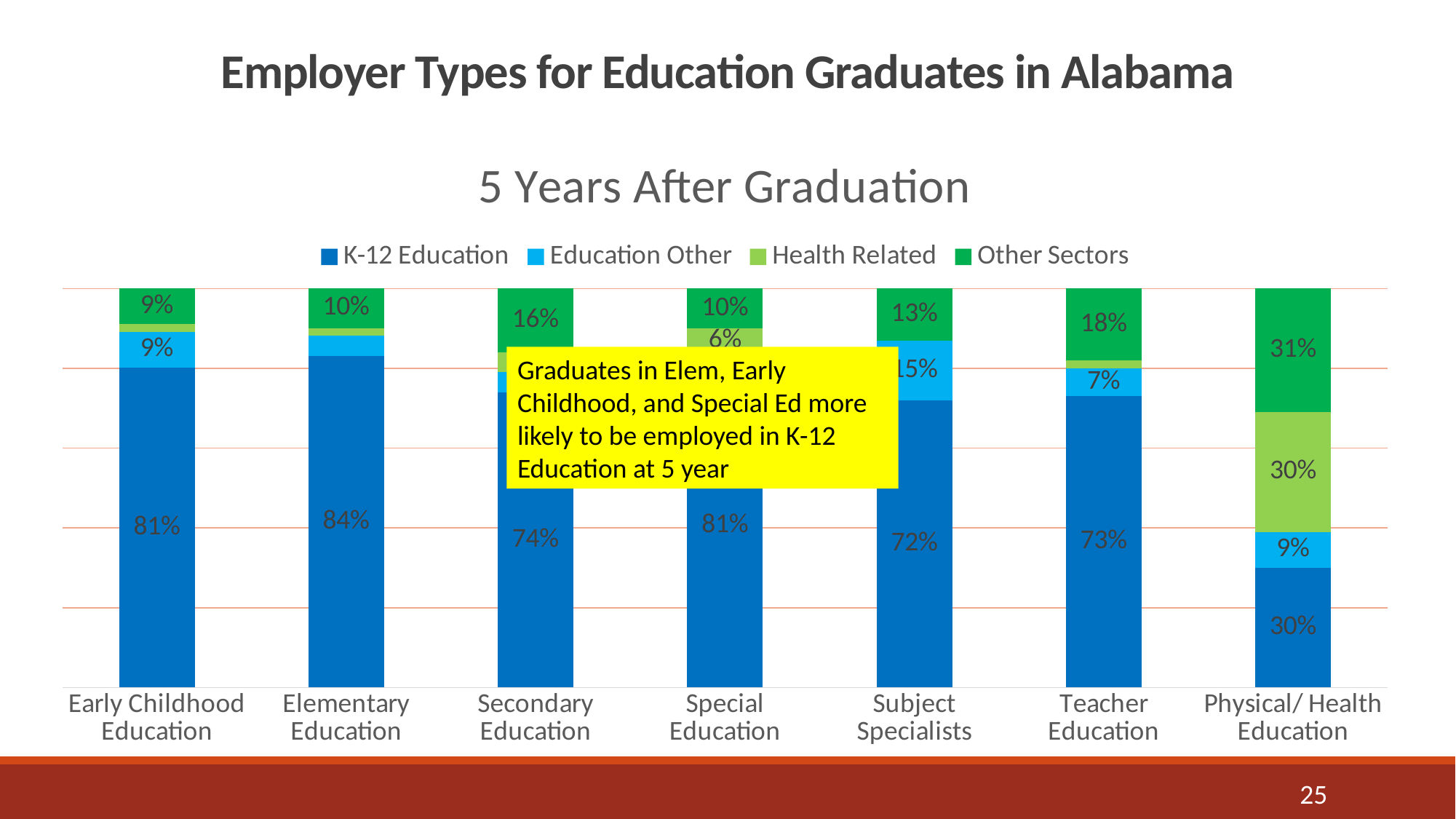
What is the Other Sectors value for Physical/ Health Education? 31% What is the difference between the K-12 Education share for Early Childhood Education and for Physical/ Health Education? 51 percentage points Which has a larger Other Sectors share, Teacher Education or Secondary Education? Teacher Education What type of chart is shown? Stacked bar chart What percentage of Elementary Education graduates are employed in K-12 Education? 84% What is the Other Sectors value for Subject Specialists? 13% Which category has the lowest K-12 Education share? Physical/ Health Education How many categories are shown on the x axis? 7 How many series does the legend list? 4 Which category has the highest K-12 Education share? Elementary Education What is the Health Related value for Physical/ Health Education? 30% What is the Education Other value for Teacher Education? 7%